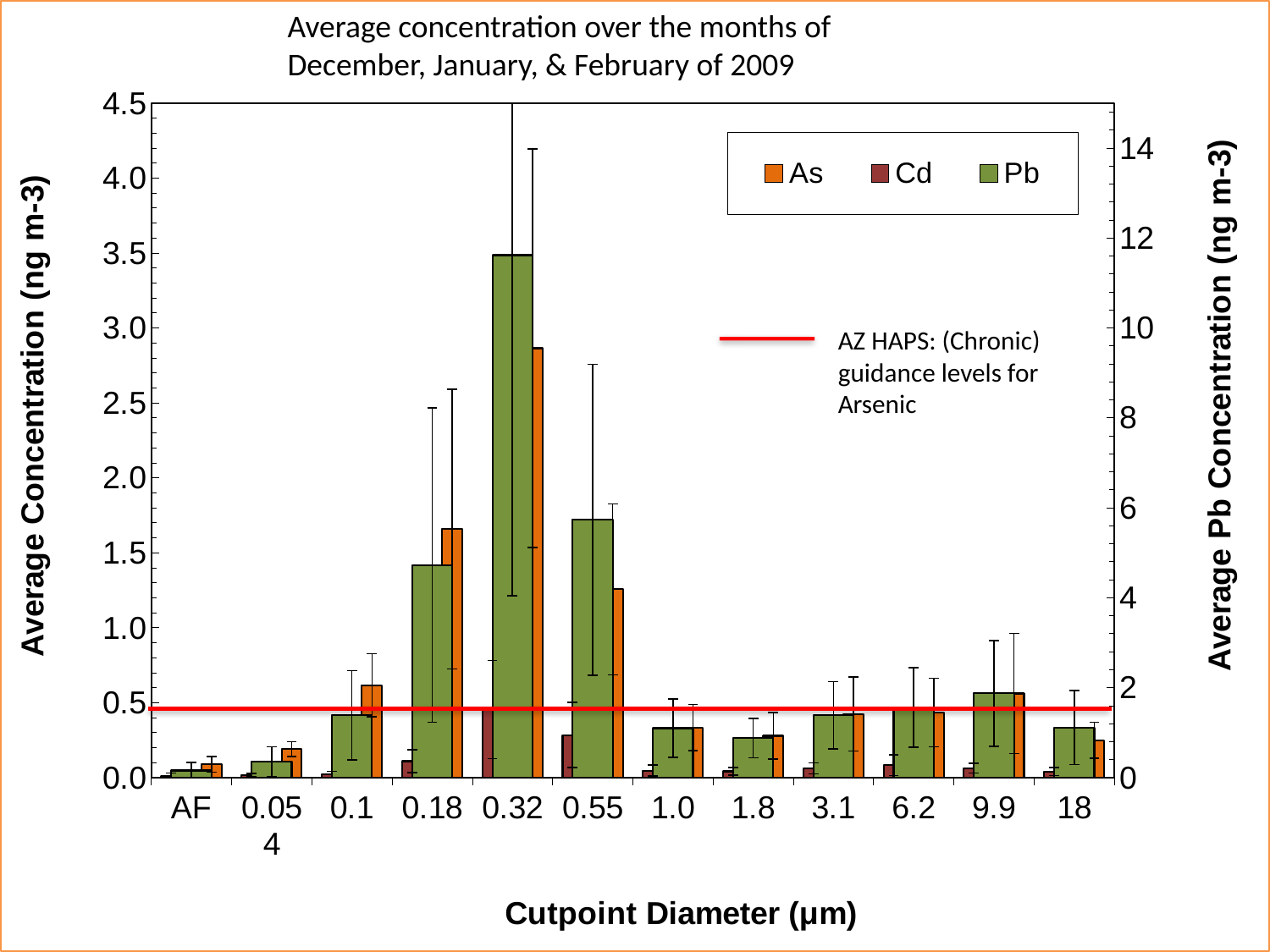
Is the As value at cutpoint diameter 0.32 greater or less than 2.5? greater How many cutpoint diameter categories are shown on the x axis? 12 Is the As value at cutpoint diameter 0.18 greater or less than 1.5? greater Which has the larger As concentration, cutpoint diameter 0.32 or 0.55? 0.32 What does the red horizontal line represent? AZ HAPS: (Chronic) guidance levels for Arsenic What is the label of the x axis? Cutpoint Diameter (µm) On the right-hand Pb axis, is the Pb value at cutpoint diameter 0.32 greater or less than 10? greater At which cutpoint diameter is the As concentration highest? 0.32 How many series does the legend list? 3 What kind of chart is shown on the slide? bar chart At which cutpoint diameter is the Pb concentration highest? 0.32